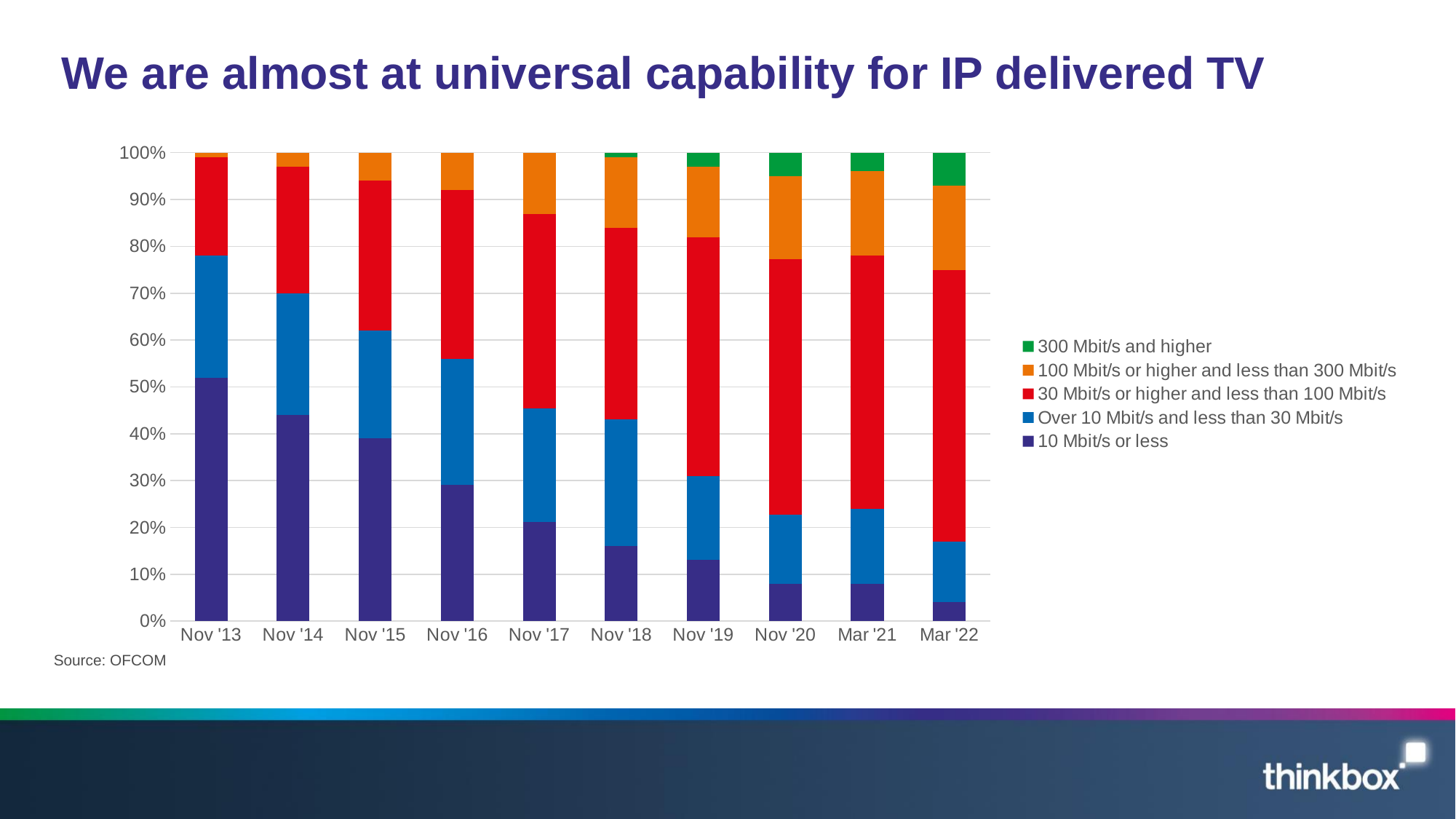
In which period is the '10 Mbit/s or less' segment the smallest? Mar '22 In which period is the '10 Mbit/s or less' segment the largest? Nov '13 Is the '10 Mbit/s or less' share for Mar '22 greater or less than 10%? less What colour represents '300 Mbit/s and higher' in the legend? Green What kind of chart is shown on the slide? Stacked bar chart How many series does the legend list? 5 What is the title of the slide? We are almost at universal capability for IP delivered TV How many time periods are shown along the x axis? 10 Does the share of '10 Mbit/s or less' rise or fall from Nov '13 to Mar '22? Fall In which period is the '300 Mbit/s and higher' segment the largest? Mar '22 Is the '10 Mbit/s or less' share for Nov '14 greater or less than 50%? less Which period has a larger '10 Mbit/s or less' share, Nov '13 or Mar '22? Nov '13